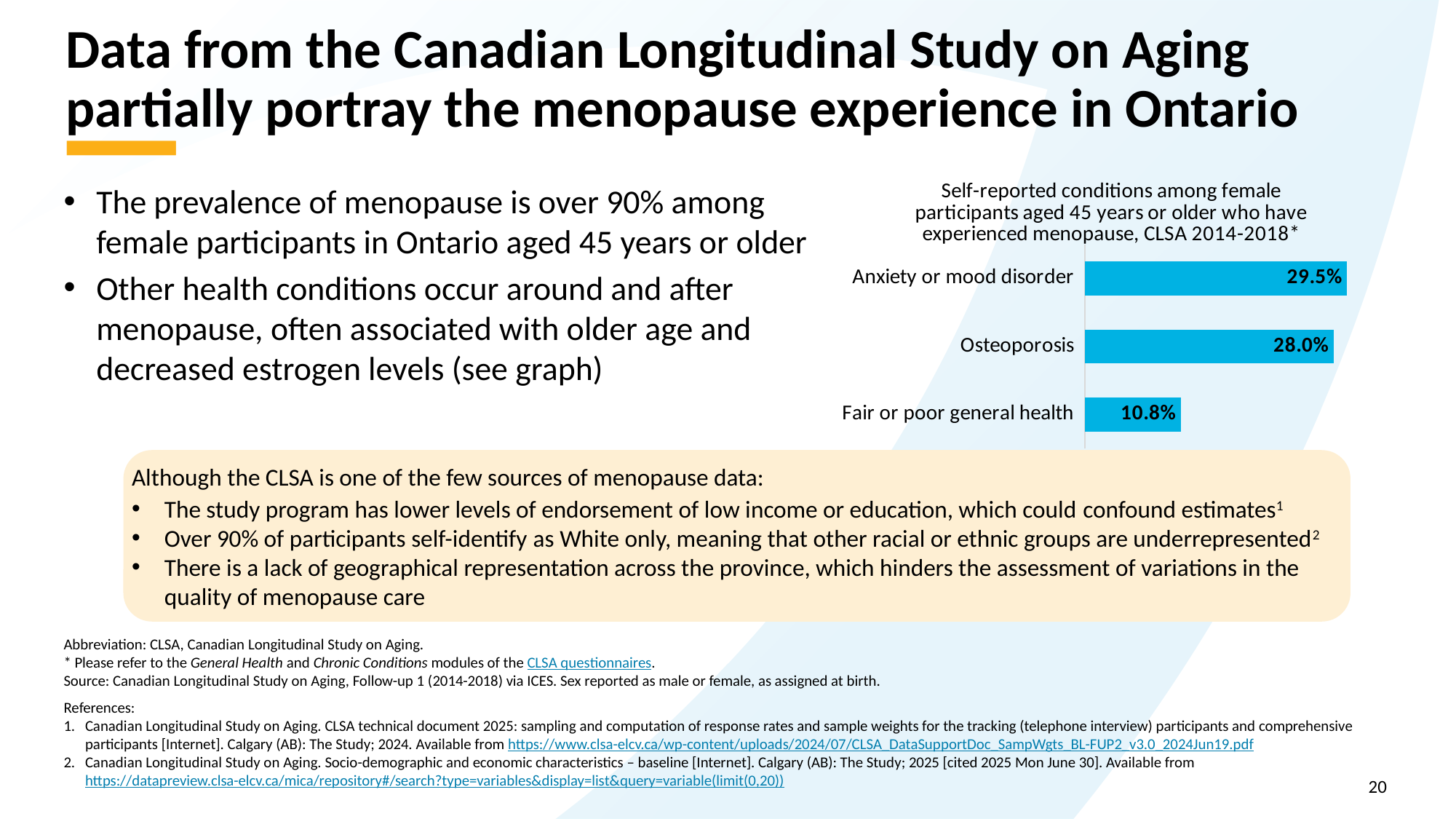
Which condition has the highest value? Anxiety or mood disorder What colour are the bars in the chart? Blue What is the value for Anxiety or mood disorder? 29.5% What kind of chart is shown on the slide? Bar chart What is the difference between the values for Osteoporosis and Fair or poor general health? 17.2% Which is larger, the value for Osteoporosis or the value for Fair or poor general health? Osteoporosis What is the difference between the values for Anxiety or mood disorder and Osteoporosis? 1.5% What is the title of the chart? Self-reported conditions among female participants aged 45 years or older who have experienced menopause, CLSA 2014-2018* What is the value for Fair or poor general health? 10.8% How many conditions are shown in the chart? 3 Which condition has the lowest value? Fair or poor general health What is the value for Osteoporosis? 28.0%